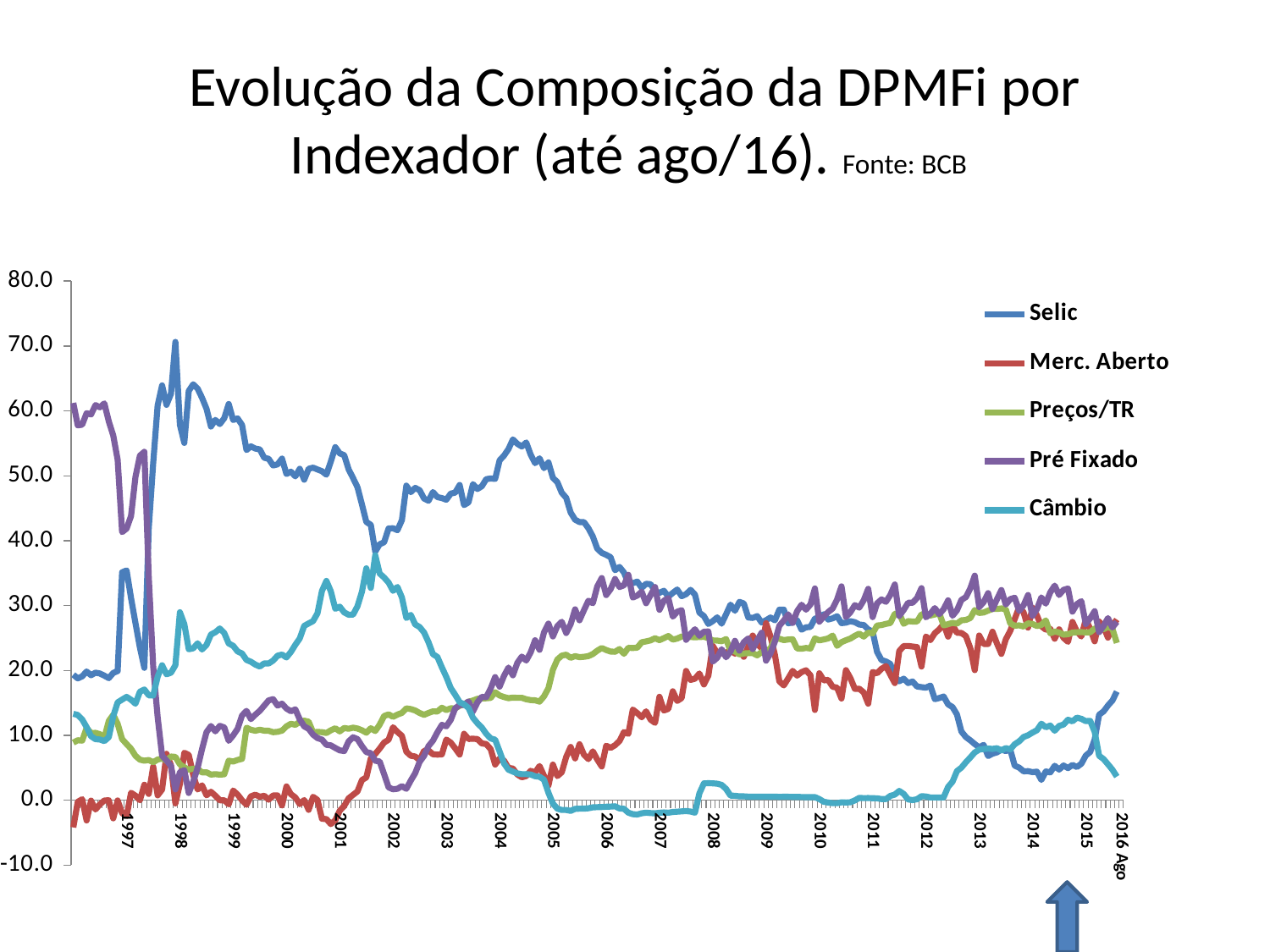
Around 2004, which is larger: Selic or Merc. Aberto? Selic Which series has the highest value around 1998? Selic Does the Selic series rise or fall between 2004 and 2013? fall Which series is plotted with the red line? Merc. Aberto Which series has the lowest value around 2010? Câmbio How many series does the legend list? 5 Is the value for Câmbio around 2010 greater or less than 10.0? less Which series has the highest value at the start of the chart in 1997? Pré Fixado What source is cited in the chart title? BCB What kind of chart is shown on the slide? line chart Is the value for Preços/TR around 2013 greater or less than 20.0? greater